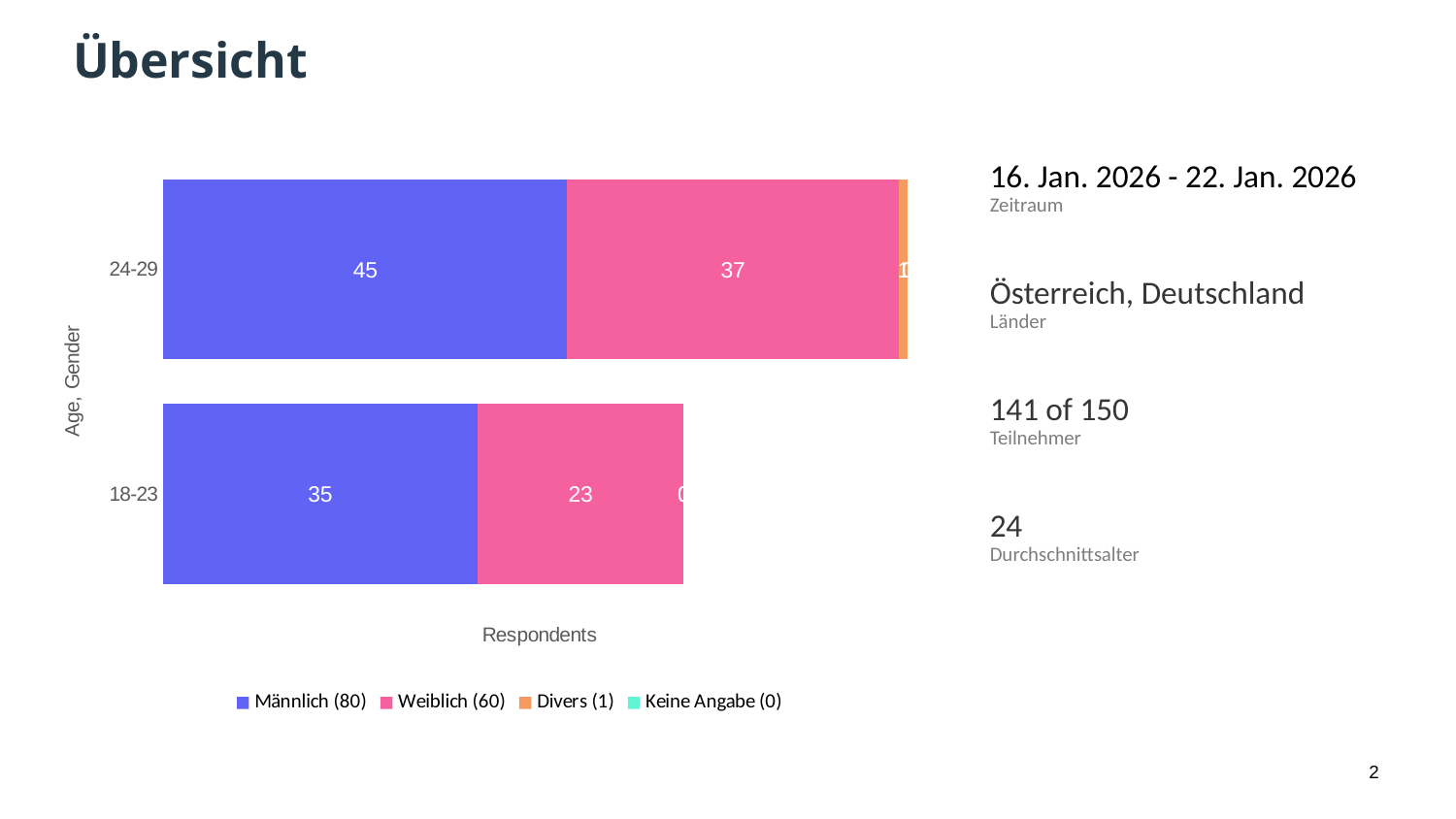
What is the Männlich value for the 18-23 age group? 35 What is the total of the stacked bar for the 18-23 age group? 58 How many series does the chart legend list? 4 Which age group has the higher Männlich value? 24-29 How many age categories are plotted on the chart? 2 What is the label on the x axis of the chart? Respondents What type of chart is shown on the slide? stacked bar chart What is the Weiblich value for the 18-23 age group? 23 What is the difference between the Männlich values for 24-29 and 18-23? 10 What is the Weiblich value for the 24-29 age group? 37 What is the Männlich value for the 24-29 age group? 45 What is the difference between the Weiblich values for 24-29 and 18-23? 14